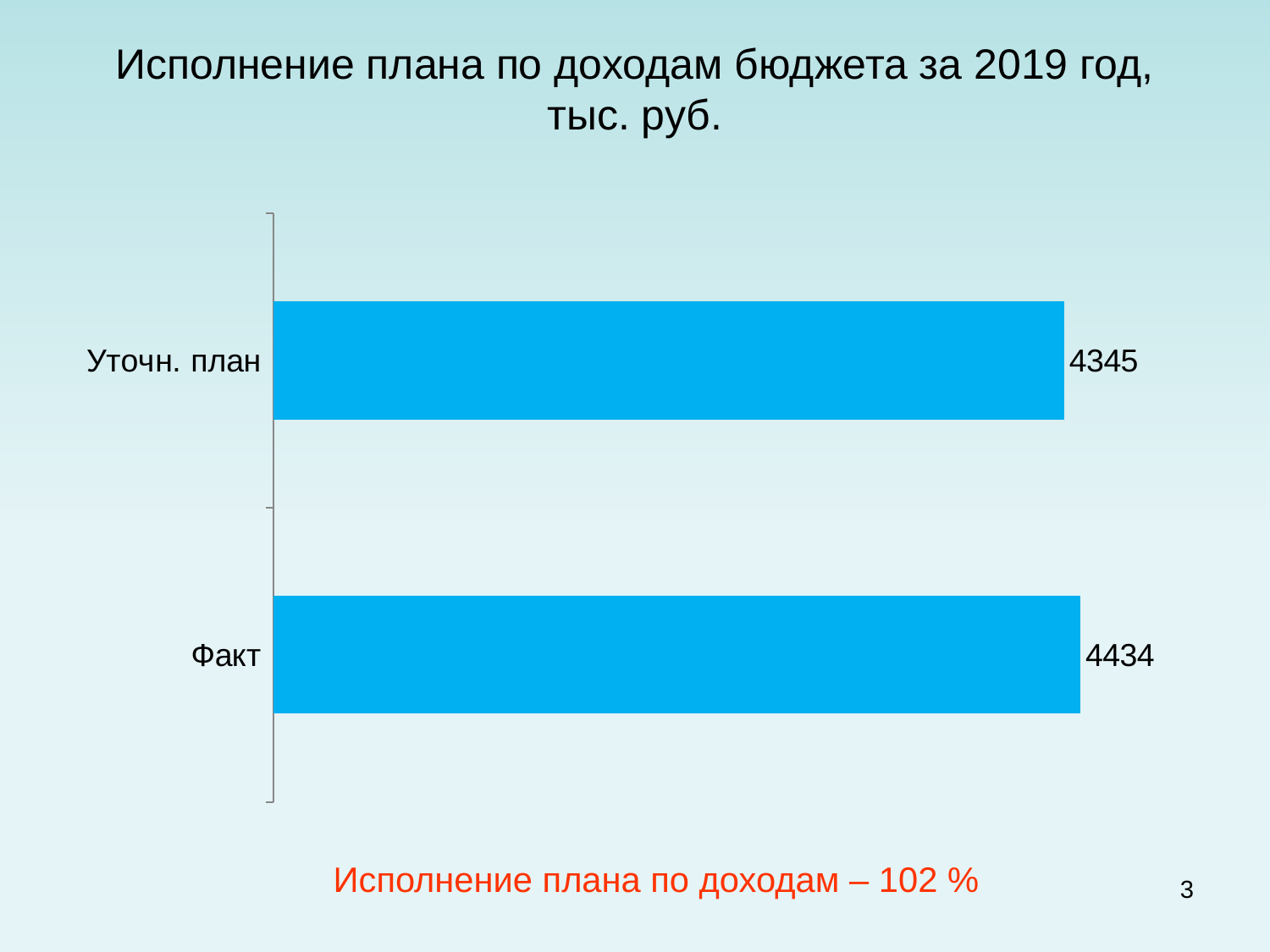
Which category has the highest value? Факт What is the value for Факт? 4434 How many categories are shown in the chart? 2 Which category has the lowest value? Уточн. план What is the difference between the values for Факт and Уточн. план? 89 Which is larger, the value for Факт or the value for Уточн. план? Факт What is the value for Уточн. план? 4345 What kind of chart is shown on the slide? bar chart What is the title of the slide? Исполнение плана по доходам бюджета за 2019 год, тыс. руб. What percentage of plan execution is stated below the chart? 102 %